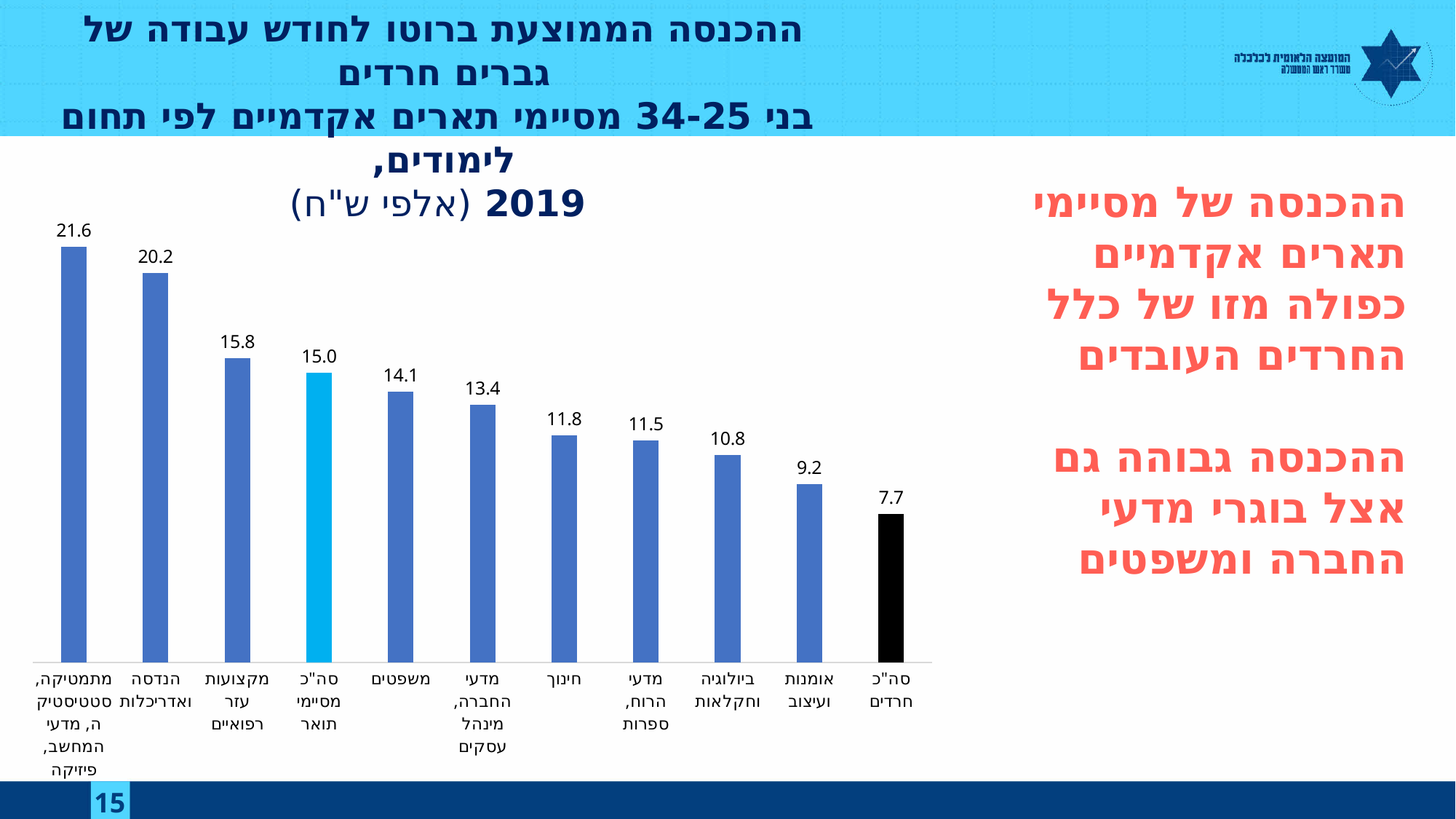
Do the values rise or fall from left to right along the x axis? fall Which category has the highest value? מתמטיקה, סטטיסטיקה, מדעי המחשב, פיזיקה What is the value for הנדסה ואדריכלות? 20.2 How many categories are shown in the chart? 11 What kind of chart is shown on the slide? bar chart What is the value for סה"כ חרדים? 7.7 Which category has the lowest value? סה"כ חרדים What is the value for סה"כ מסיימי תואר? 15.0 What is the difference between the values for סה"כ מסיימי תואר and סה"כ חרדים? 7.3 Which is larger, the value for חינוך or the value for ביולוגיה וחקלאות? חינוך What colour is the bar for סה"כ חרדים? black What is the value for משפטים? 14.1